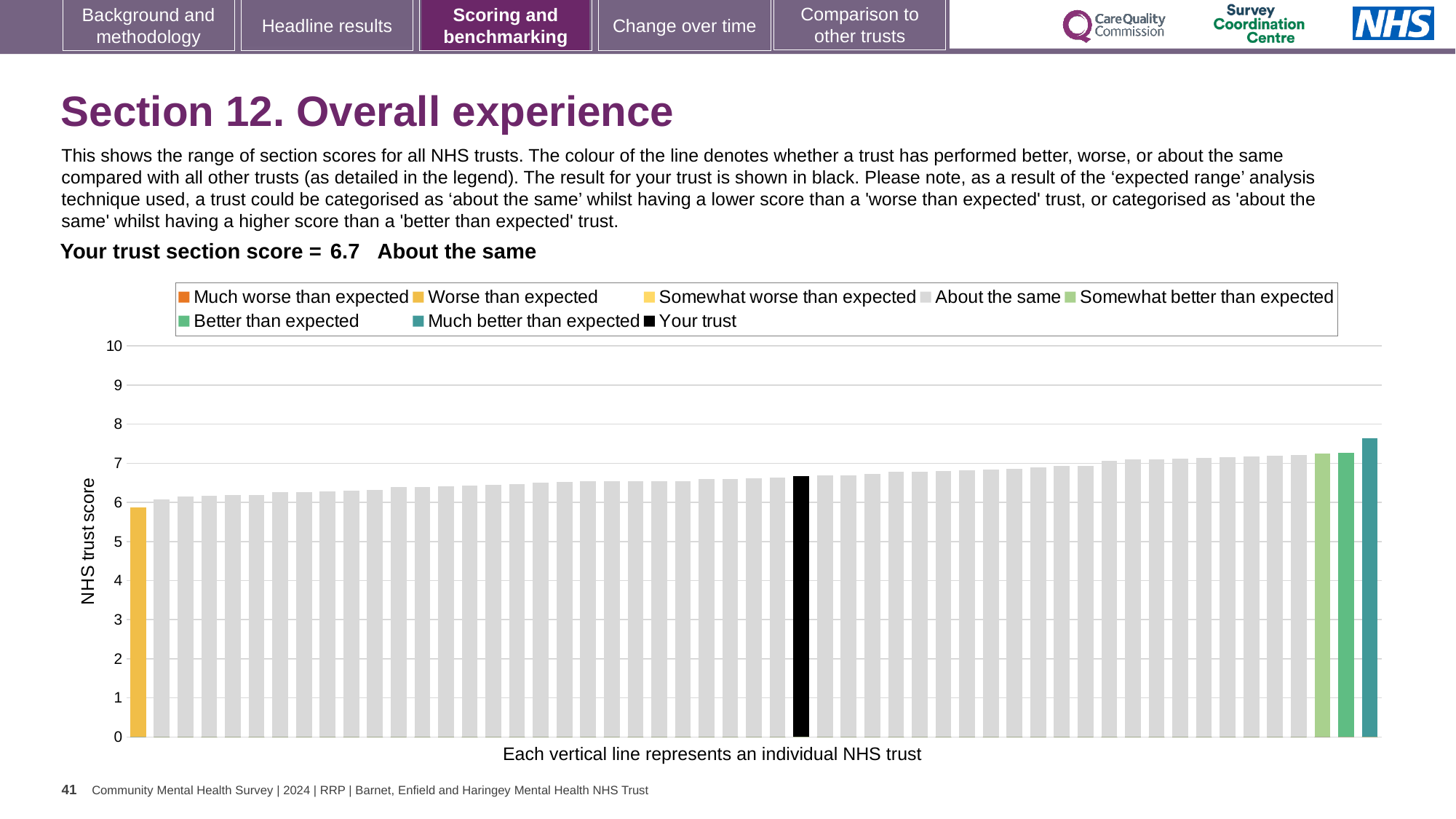
Do the bar values rise or fall from left to right across the chart? rise How many entries does the chart legend list? 8 What is the label on the vertical axis of the chart? NHS trust score What is the section score for your trust shown on the slide? 6.7 How many bars in the chart are coloured yellow (Worse than expected)? 1 What does each vertical line in the chart represent, according to the axis label? an individual NHS trust What kind of chart is shown on the slide? bar chart Which is taller: the black bar for your trust or the yellow bar at the far left? the black bar for your trust Is the value of the shortest bar in the chart greater or less than 7? less Is the value of the tallest bar in the chart greater or less than 7? greater Is the value for your trust (the black bar) greater or less than 5? greater Which legend category does the tallest bar in the chart belong to? Much better than expected